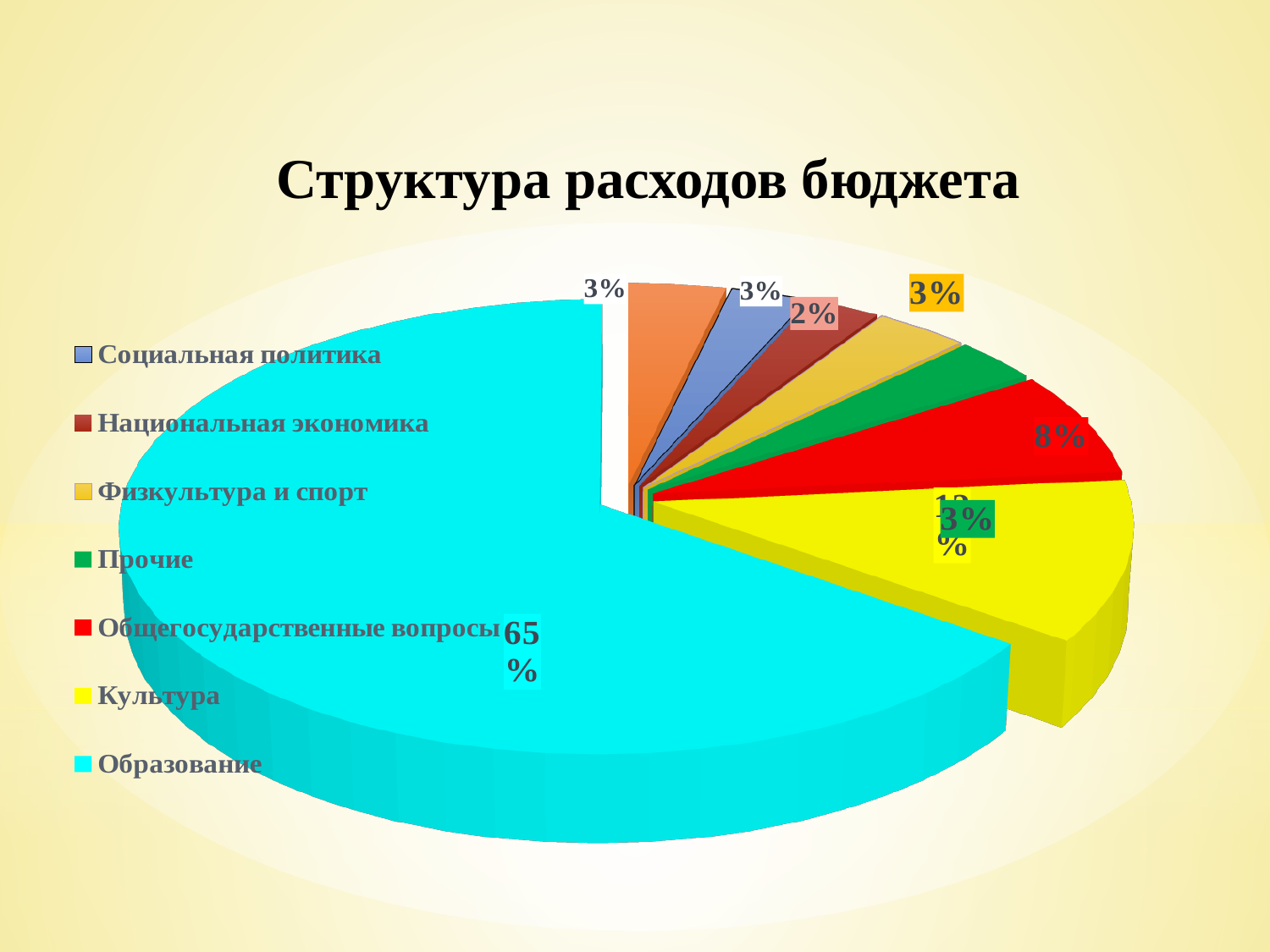
Which is larger: the share for Образование or the share for Общегосударственные вопросы? Образование What share of the pie does Прочие have? 3% What kind of chart is shown on the slide? Pie chart Which category has the largest share of the pie? Образование Which category has the smallest share of the pie? Национальная экономика What share of the pie does Образование have? 65% What is the difference in percentage points between Образование and Общегосударственные вопросы? 57 What share of the pie does Социальная политика have? 3% What is the title of the chart? Структура расходов бюджета What share of the pie does Общегосударственные вопросы have? 8% How many entries does the legend list? 7 What share of the pie does Национальная экономика have? 2%